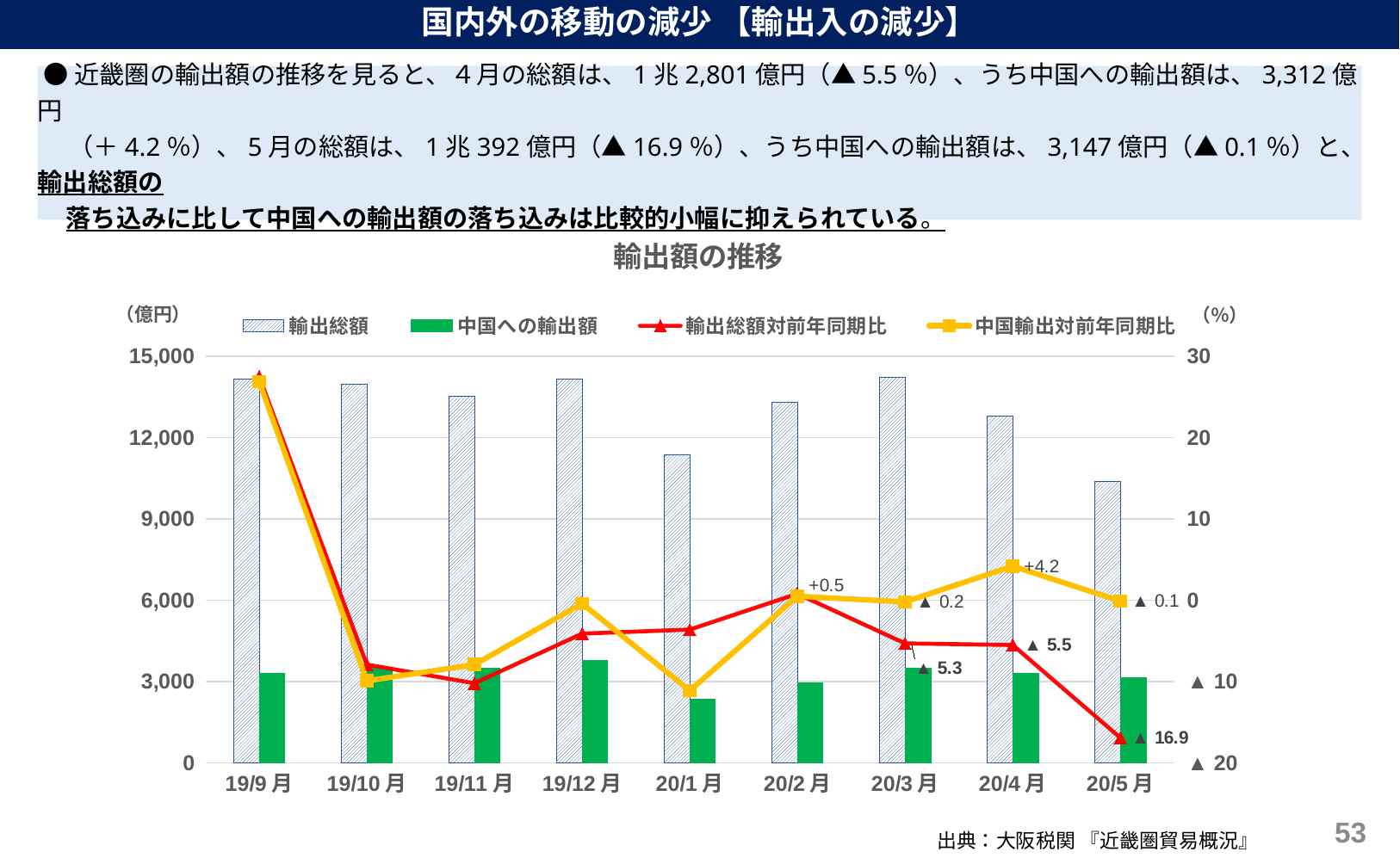
What is the value of 中国輸出対前年同期比 for 20/5月? ▲0.1 Is the value of 中国への輸出額 for 20/1月 greater or less than 3,000? less In which month is 輸出総額 lowest? 20/5月 What is the value of 輸出総額対前年同期比 for 20/4月? ▲5.5 What is the value of 輸出総額対前年同期比 for 20/5月? ▲16.9 Which is larger, 輸出総額 for 20/4月 or for 20/5月? 20/4月 What kind of chart is shown on the slide? A combined bar and line chart What is the value of 中国輸出対前年同期比 for 20/4月? +4.2 How many series does the legend list? 4 What is the title of the chart? 輸出額の推移 How many months are shown on the x axis? 9 Is the value of 輸出総額 for 20/5月 greater or less than 12,000? less